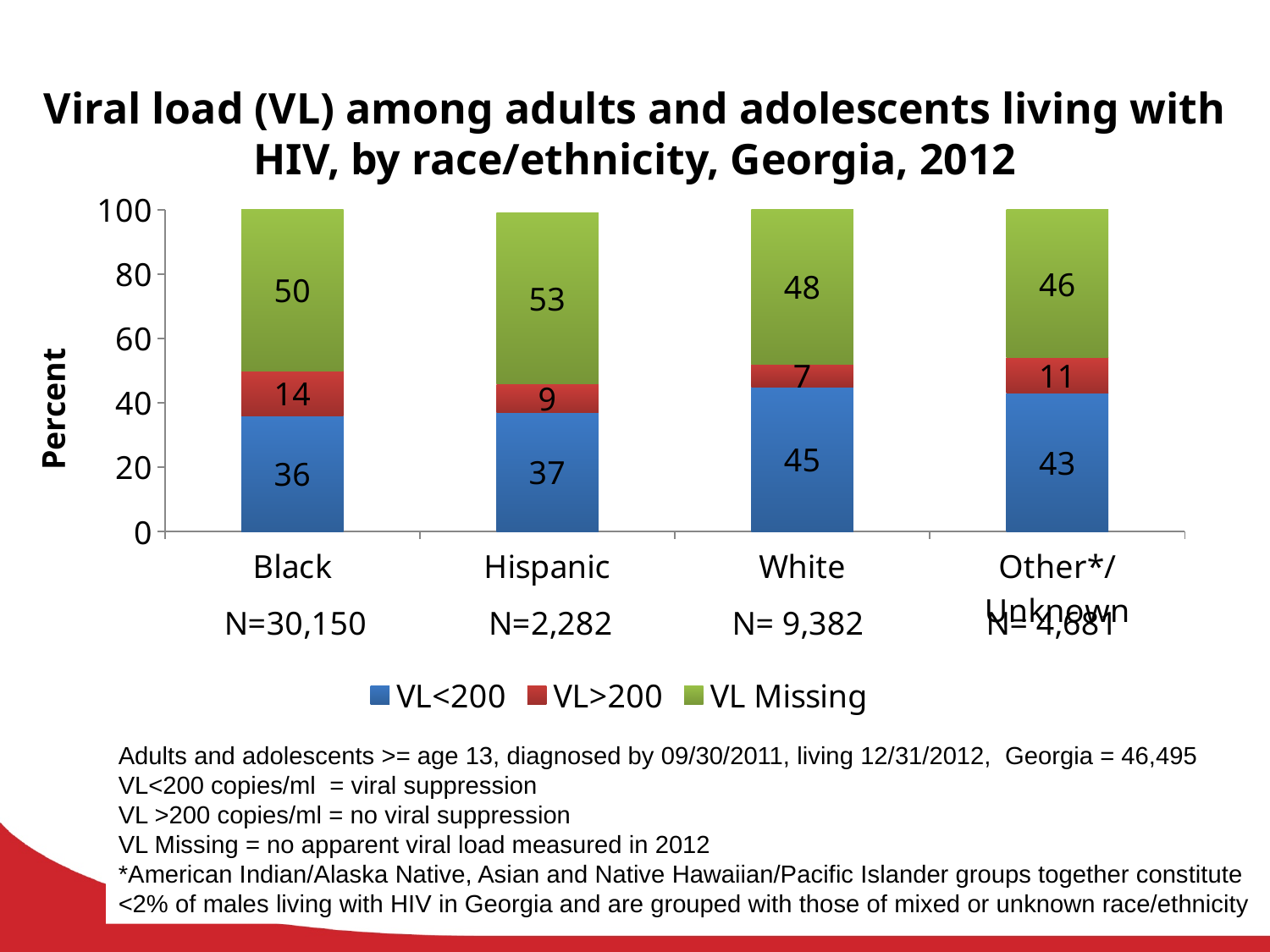
What kind of chart is shown on the slide? Stacked bar chart How many race/ethnicity categories are shown on the x axis? 4 What is the VL Missing value for Hispanic? 53 What is the difference between the VL<200 values for White and Black? 9 What is the total of the stacked bar for Hispanic? 99 Which race/ethnicity group has the highest VL<200 value? White What is the VL<200 value for Black? 36 Which is larger, the VL Missing value for Black or for Other*/Unknown? Black What is the VL>200 value for White? 7 How many series does the legend list? 3 Which race/ethnicity group has the lowest VL>200 value? White What is the label of the y axis? Percent